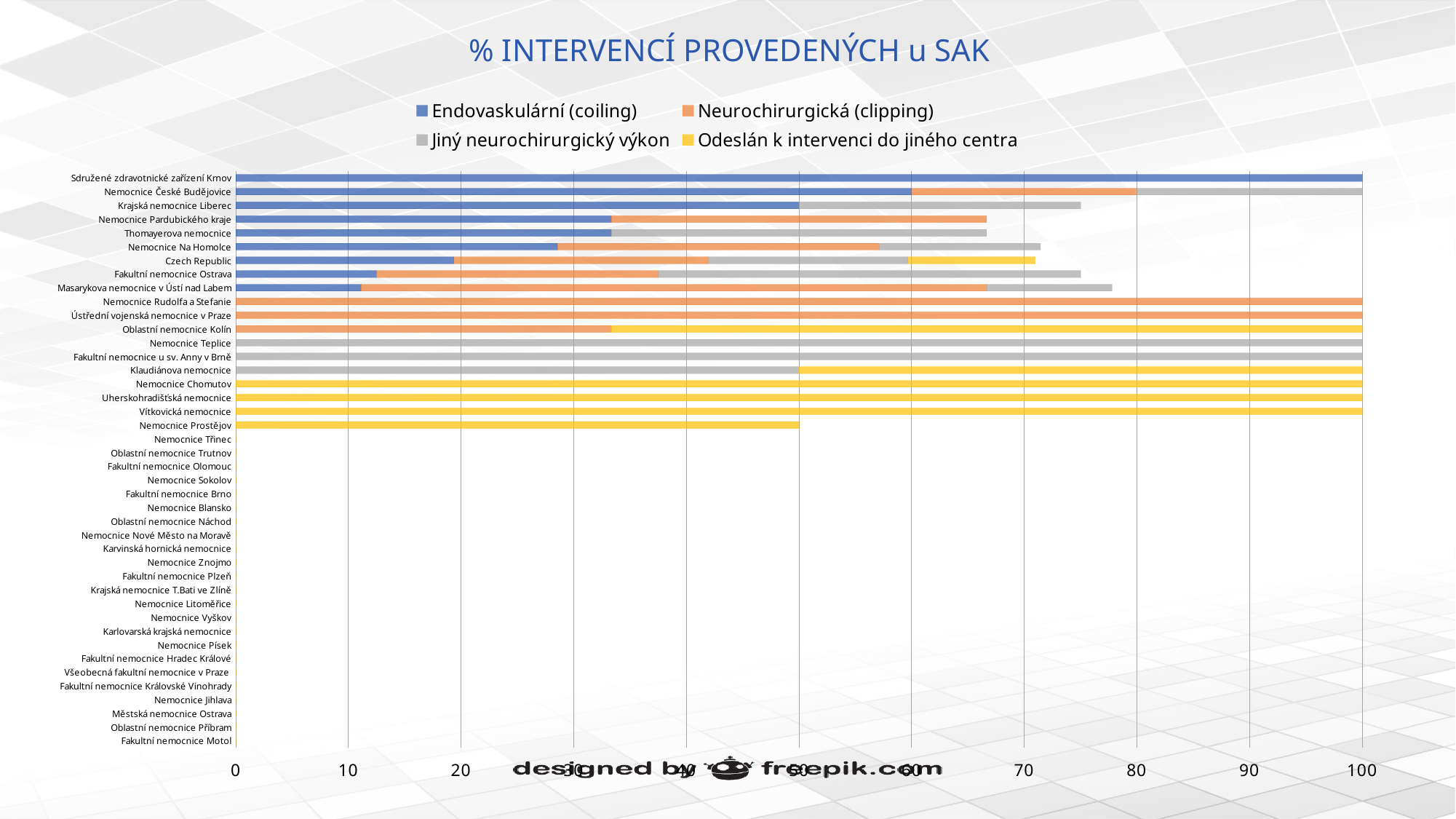
What is the value of Endovaskulární (coiling) for Krajská nemocnice Liberec? 50 Which series is shown in yellow in the legend? Odeslán k intervenci do jiného centra What is the value of Jiný neurochirurgický výkon for Klaudiánova nemocnice? 50 What kind of chart is shown on the slide? Stacked bar chart What is the value of Endovaskulární (coiling) for Sdružené zdravotnické zařízení Krnov? 100 What is the title of the chart? % INTERVENCÍ PROVEDENÝCH u SAK Which has the larger Endovaskulární (coiling) value, Sdružené zdravotnické zařízení Krnov or Krajská nemocnice Liberec? Sdružené zdravotnické zařízení Krnov What is the value of Odeslán k intervenci do jiného centra for Nemocnice Prostějov? 50 How many series does the legend list? 4 Is the Endovaskulární (coiling) value for Nemocnice Pardubického kraje greater or less than 30? greater What is the value of Neurochirurgická (clipping) for Nemocnice Rudolfa a Stefanie? 100